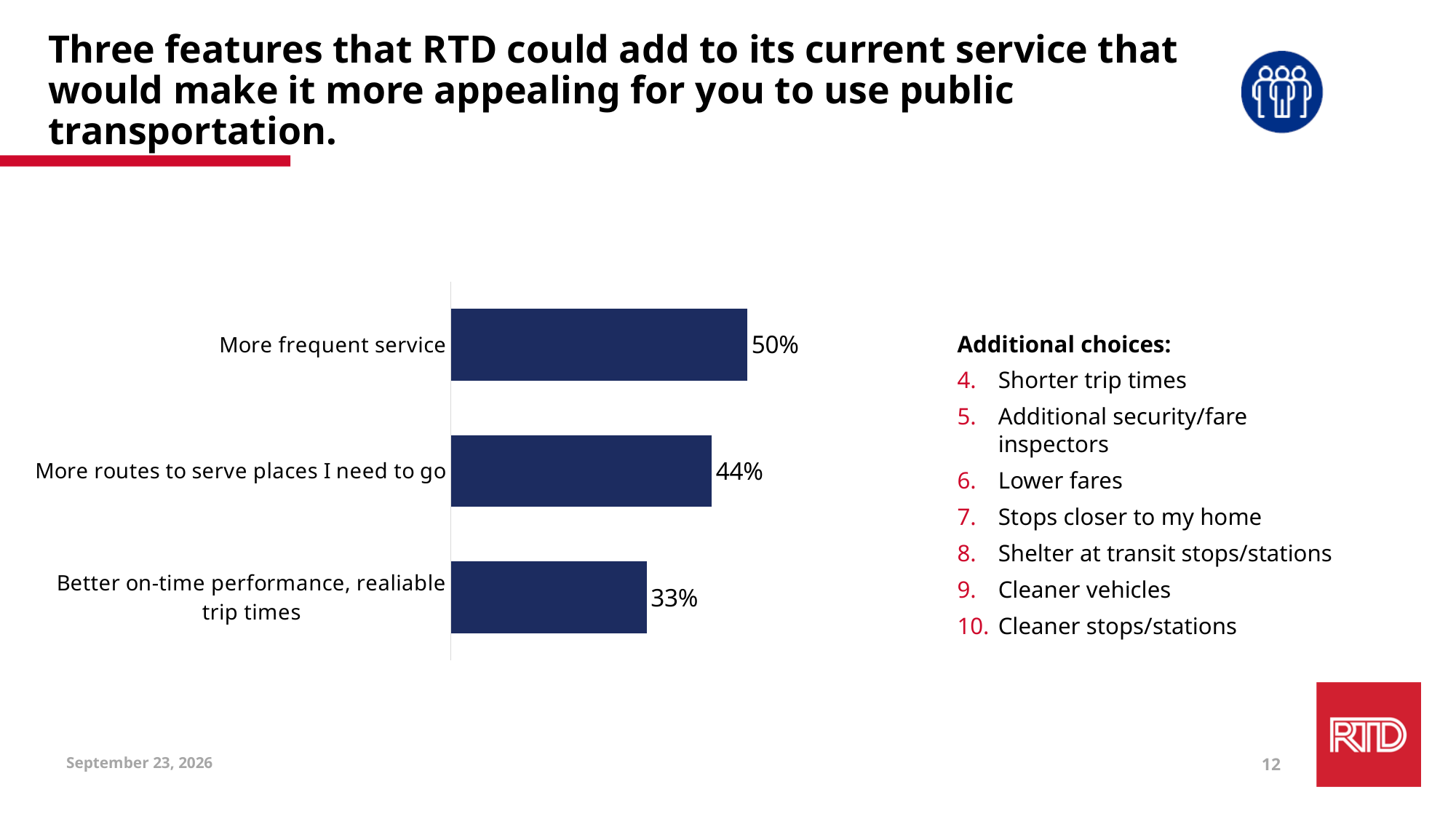
What percentage of respondents chose "More frequent service"? 50% What is the difference in percentage points between "More routes to serve places I need to go" and "Better on-time performance, realiable trip times"? 11 percentage points What colour are the bars in the chart? Dark navy blue What is the value for "More routes to serve places I need to go"? 44% Do the bar values increase or decrease from top to bottom? Decrease Which feature has the highest percentage? More frequent service What is the difference in percentage points between "More frequent service" and "More routes to serve places I need to go"? 6 percentage points What is the value for "Better on-time performance, realiable trip times"? 33% How many features are shown as bars in the chart? 3 Which feature has the lowest percentage? Better on-time performance, realiable trip times What kind of chart is shown on the slide? Bar chart Which is larger: the value for "More frequent service" or for "Better on-time performance, realiable trip times"? More frequent service